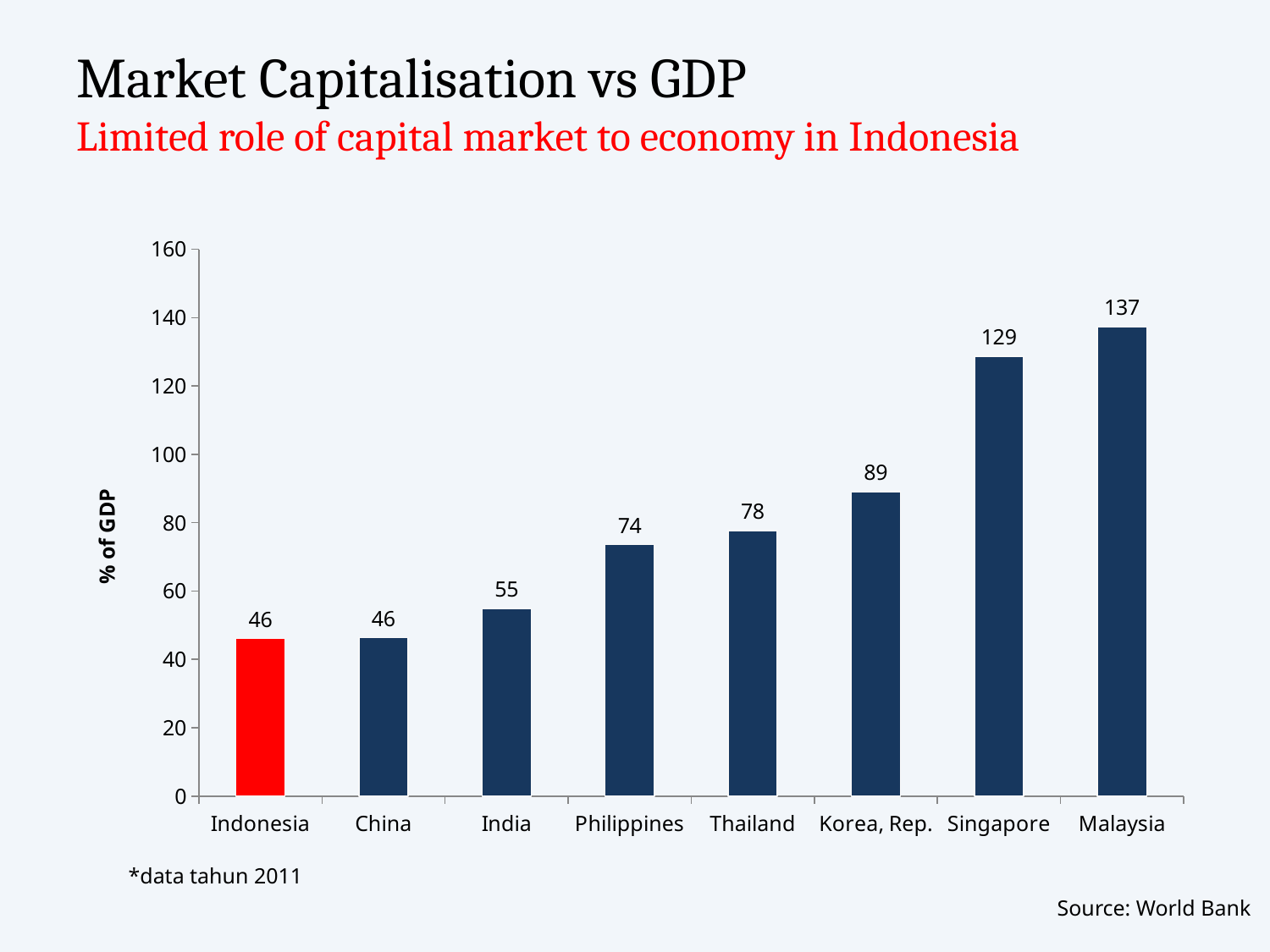
Do the values rise or fall from left to right along the x axis? rise What is the market capitalisation as % of GDP for Indonesia? 46 What is the value shown for Thailand? 78 What is the difference between the values for Malaysia and Indonesia? 91 What is the difference between the values for Korea, Rep. and Philippines? 15 What kind of chart is shown on the slide? bar chart What is the value shown for Singapore? 129 Which country's bar is coloured red? Indonesia Which is larger, the value for India or the value for Thailand? Thailand Is the value for Korea, Rep. greater or less than 100? less How many countries are shown on the chart? 8 Which country has the highest market capitalisation as % of GDP? Malaysia